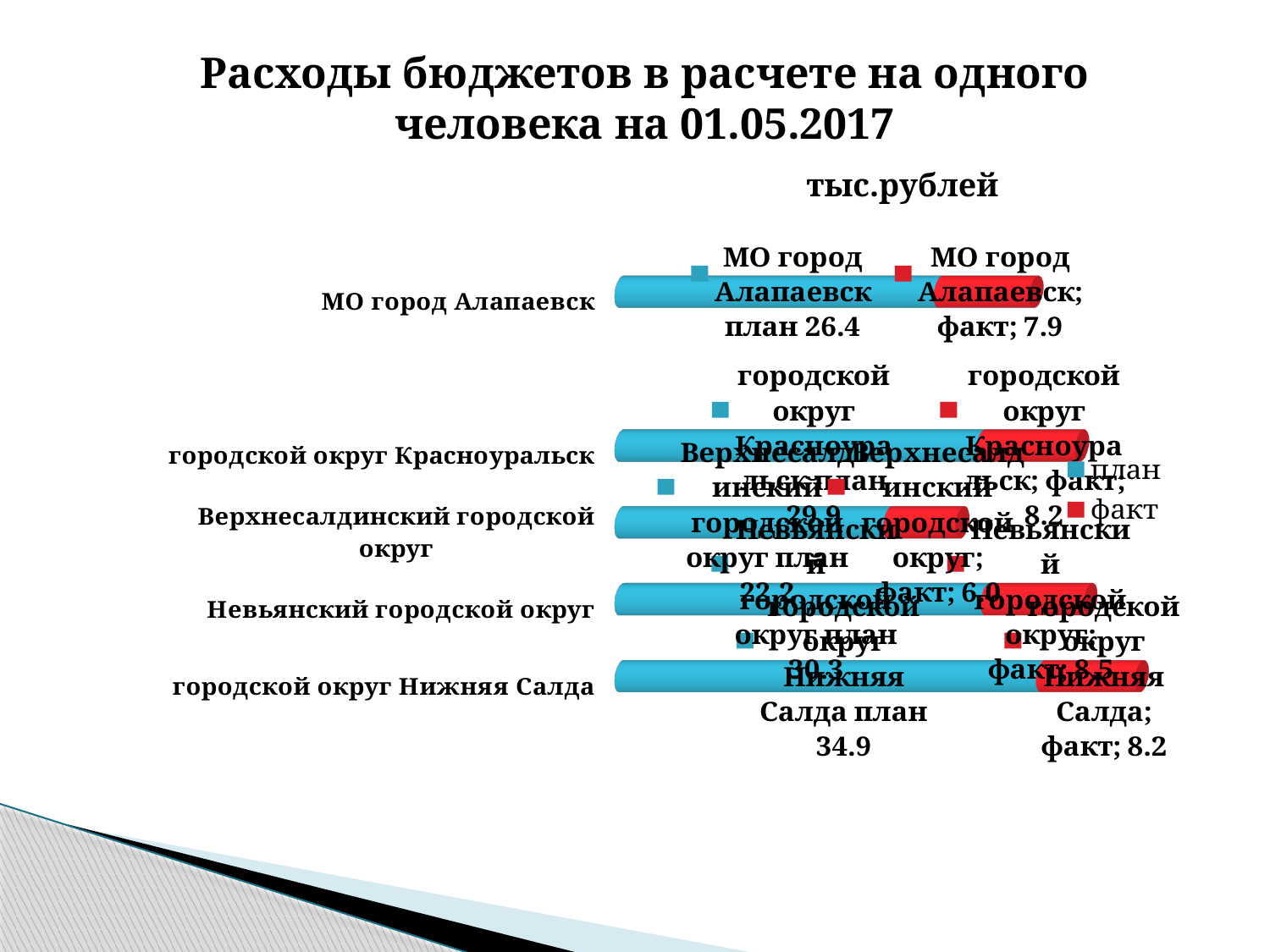
How many categories are shown in the chart? 5 What is the план value for Невьянский городской округ? 30.3 Which category has the highest план value? городской округ Нижняя Салда Which category has the lowest план value? Верхнесалдинский городской округ What type of chart is shown on the slide? bar chart What is the difference between the план and факт values for МО город Алапаевск? 18.5 What is the план value for МО город Алапаевск? 26.4 How many series does the legend list? 2 Which is larger: the план value for городской округ Красноуральск or the план value for Невьянский городской округ? Невьянский городской округ What is the факт value for Верхнесалдинский городской округ? 6.0 Which category has the lowest факт value? Верхнесалдинский городской округ What is the факт value for городской округ Нижняя Салда? 8.2